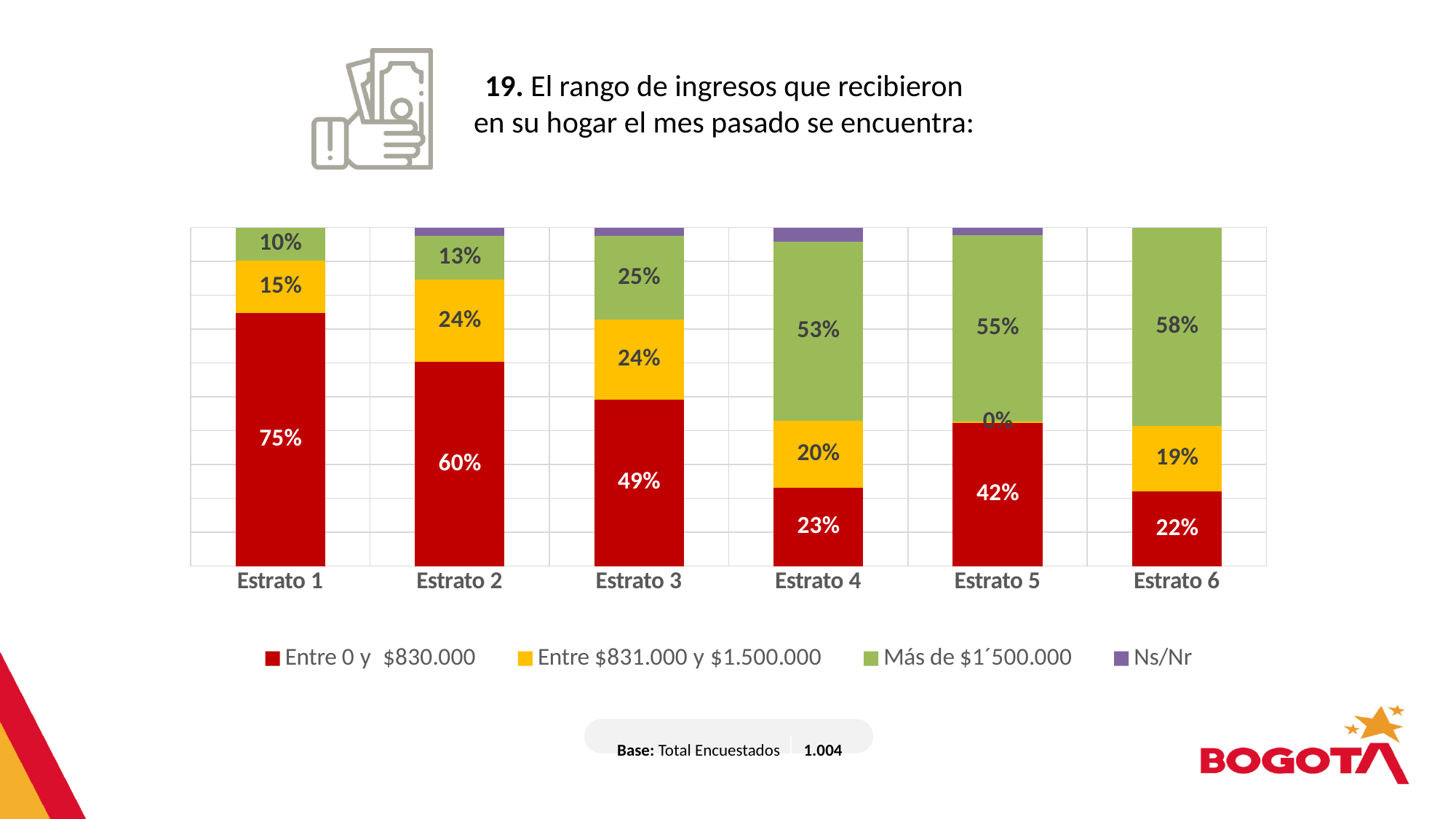
Does the 'Más de $1´500.000' series generally rise or fall from Estrato 1 to Estrato 6? Rise Which is larger: the 'Más de $1´500.000' value for Estrato 5 or for Estrato 6? Estrato 6 How many categories (estratos) are shown on the x axis? 6 What is the value for 'Más de $1´500.000' in Estrato 4? 53% How many series does the legend list? 4 What is the value for 'Entre $831.000 y $1.500.000' in Estrato 6? 19% Which estrato has the highest value for 'Entre 0 y $830.000'? Estrato 1 What kind of chart is shown on the slide? Stacked bar chart Which estrato has the lowest value for 'Más de $1´500.000'? Estrato 1 What is the value for 'Entre $831.000 y $1.500.000' in Estrato 5? 0% What is the difference between the 'Entre 0 y $830.000' values for Estrato 1 and Estrato 2? 15% What is the value for 'Entre 0 y $830.000' in Estrato 1? 75%